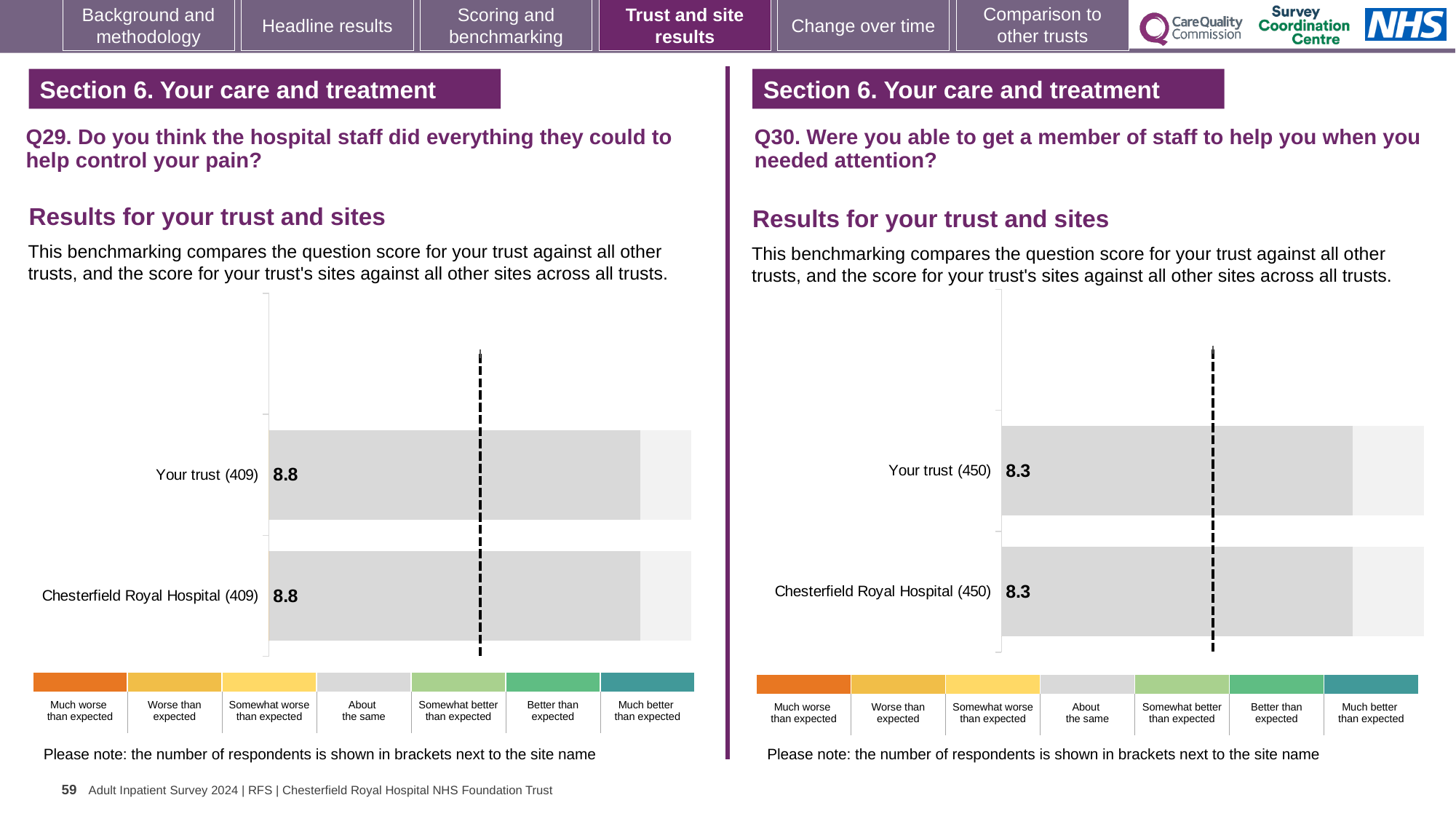
In the Q29 chart on the left, how many respondents are shown in brackets next to Your trust? 409 In the Q30 chart on the right, how many respondents are shown in brackets next to Chesterfield Royal Hospital? 450 In the Q29 chart on the left, what is the score for Chesterfield Royal Hospital? 8.8 How many bars are plotted in the Q30 chart on the right? 2 In the Q30 chart on the right, what is the score for Chesterfield Royal Hospital? 8.3 In the Q29 chart on the left, what is the score for Your trust? 8.8 How many categories does the colour key below the Q29 chart on the left list? 7 How many bars are plotted in the Q29 chart on the left? 2 In the colour key below the Q30 chart on the right, which category is shown in grey? About the same What kind of chart is used for the Q30 results on the right? Bar chart In the Q30 chart on the right, what is the score for Your trust? 8.3 In the Q29 chart on the left, what is the difference between the score for Your trust and the score for Chesterfield Royal Hospital? 0